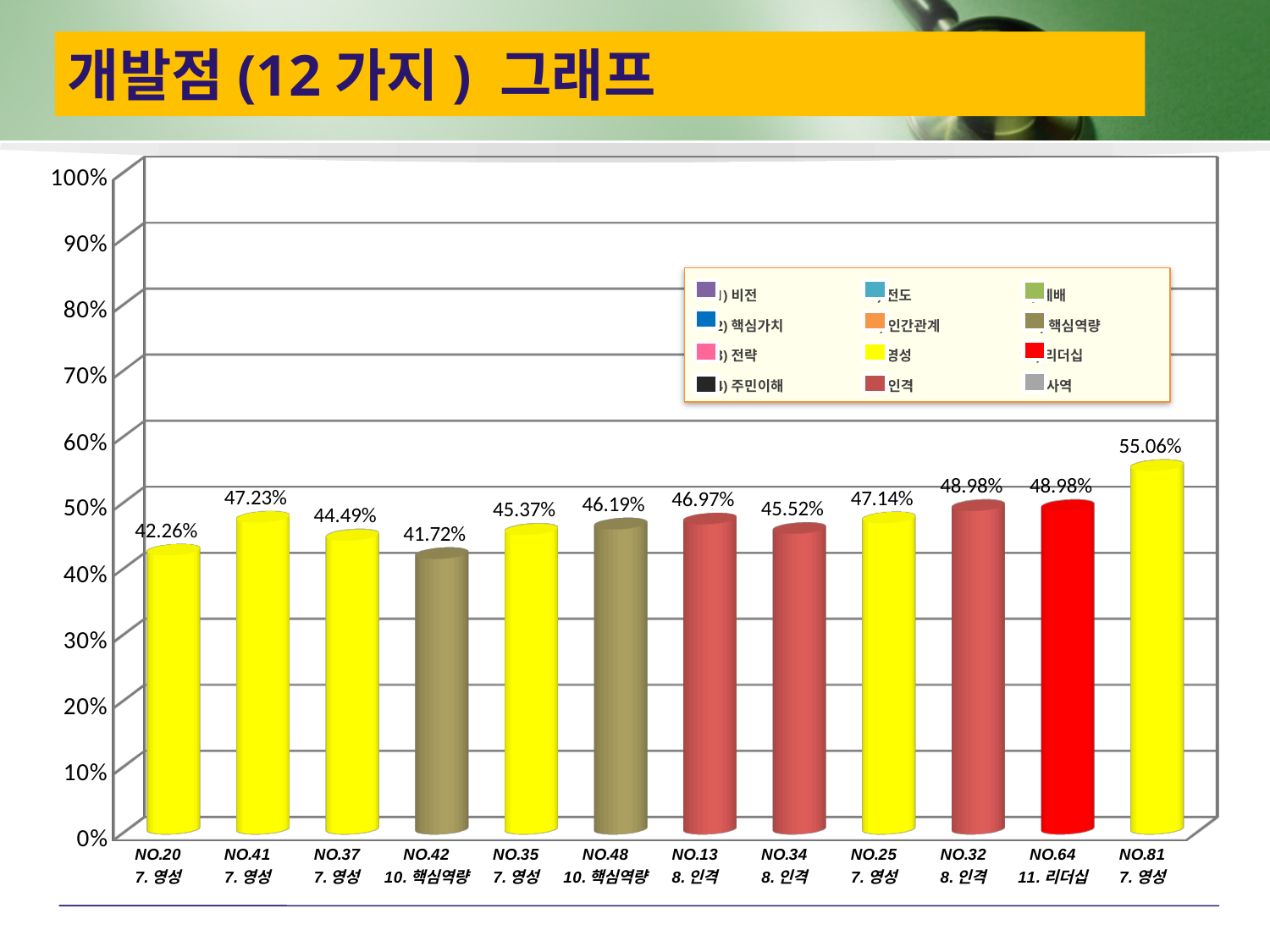
How many entries does the legend list? 12 What is the value for NO.13 (8. 인격)? 46.97% What type of chart is shown on the slide? Bar chart How many bars are plotted in the chart? 12 What is the value for NO.81 (7. 영성)? 55.06% What colour is the bar for NO.64 (11. 리더십)? Red Which category has the lowest value? NO.42 (10. 핵심역량) Is the value for NO.81 greater or less than 50%? greater Which category has the highest value? NO.81 (7. 영성) What is the difference between the values for NO.81 and NO.42? 13.34% Which is larger, the value for NO.41 or the value for NO.37? NO.41 What is the value for NO.42 (10. 핵심역량)? 41.72%